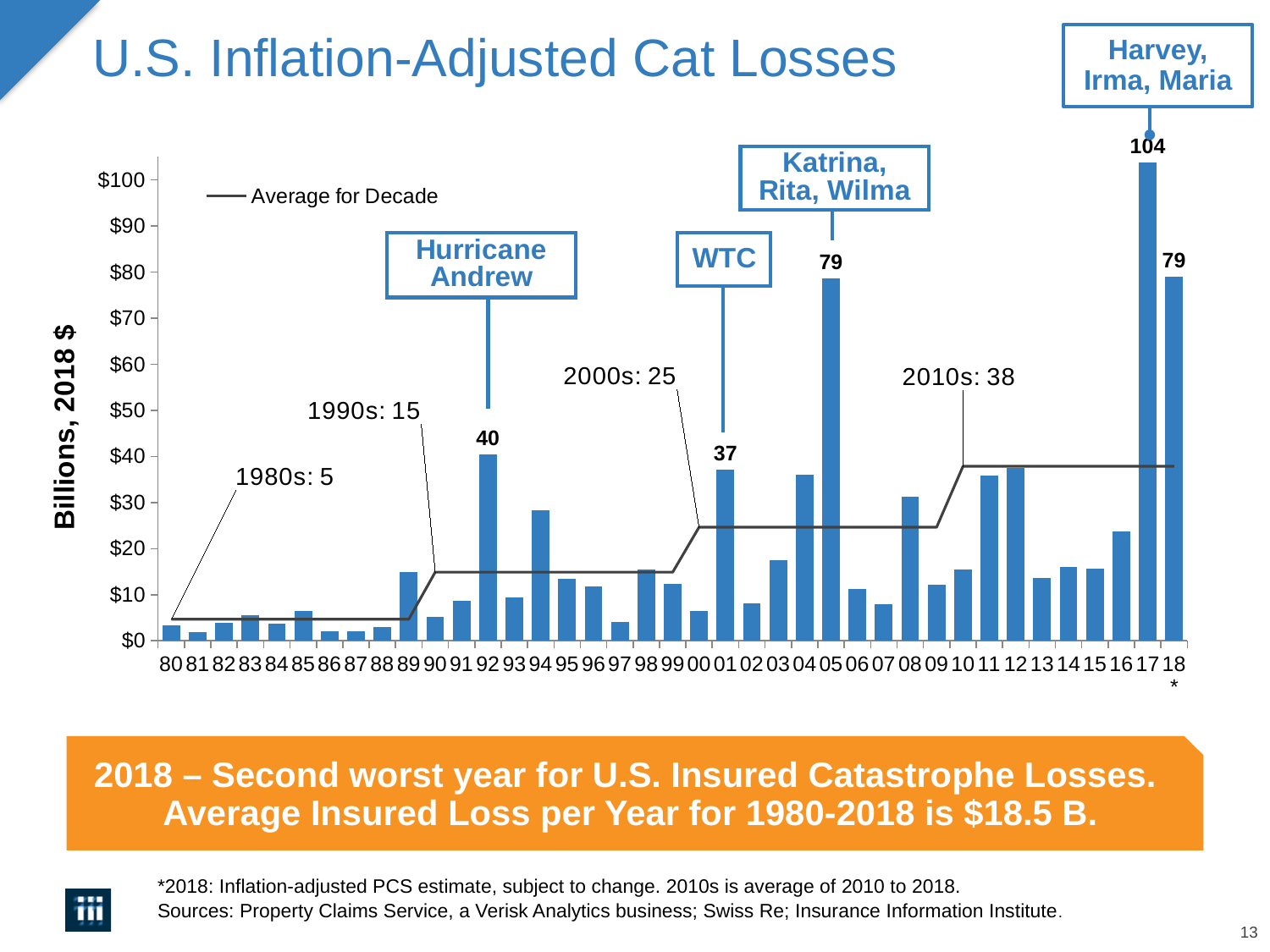
What is the average for the 2010s shown on the chart? 38 Is the value for 1994 greater or less than $20? greater Is the value for 2016 greater or less than $30? less What kind of chart is used to show the annual cat losses? bar chart What is the value for 1992 (labeled 92) in the chart? 40 What is the difference between the values for 2017 and 2018? 25 Which is larger, the value for 2001 or the value for 1992? 1992 Which year has the highest inflation-adjusted cat losses? 2017 How many years (bars) are plotted in the chart? 39 Do the decade averages rise or fall from the 1980s to the 2010s? rise What is the value for 2017 (labeled 17) in the chart? 104 What is the difference between the values for 2005 and 2001? 42